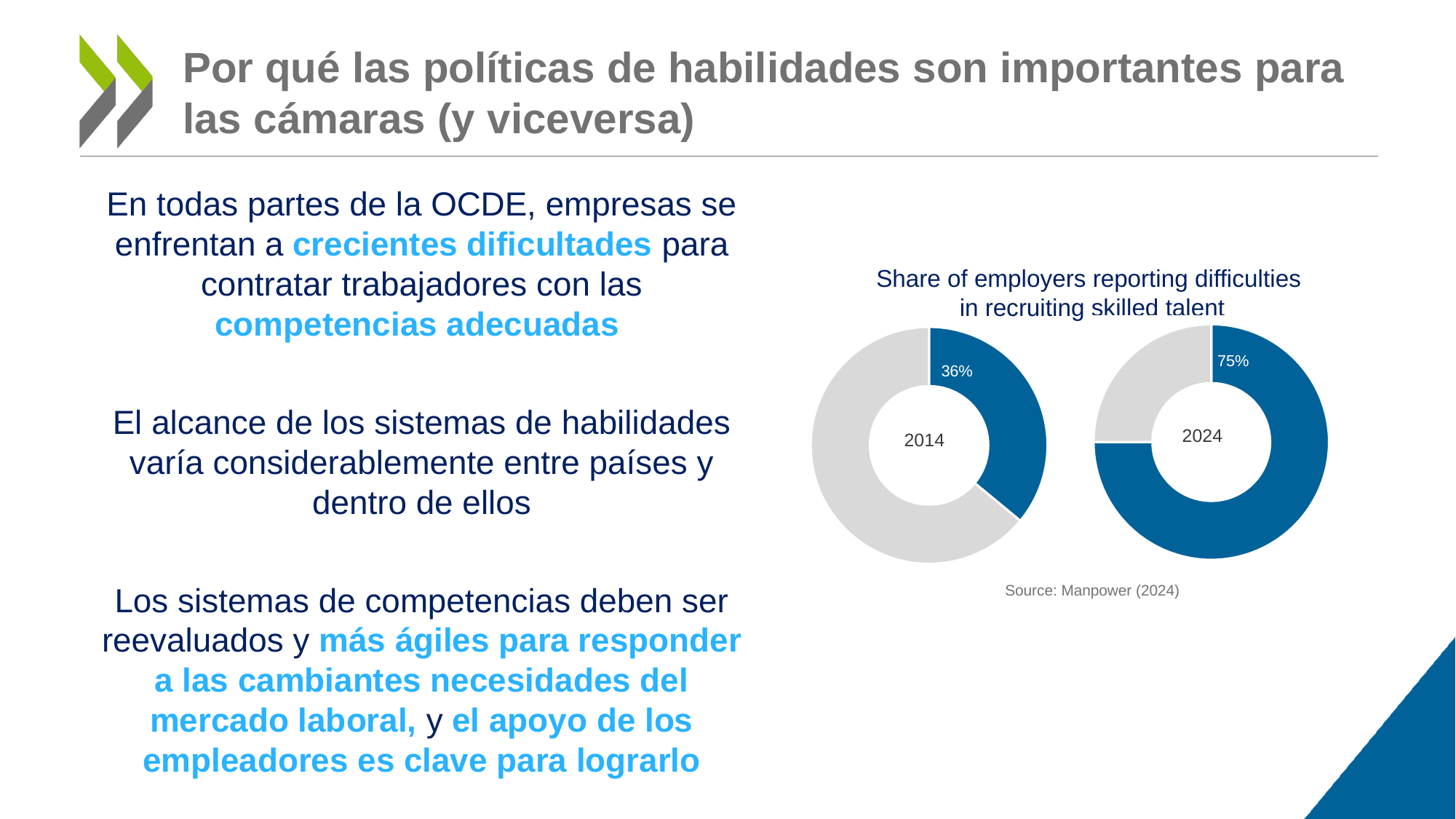
In the 2014 donut chart, is the highlighted share greater or less than 50%? less Comparing the 2014 and 2024 donut charts, which year shows the lower share of employers reporting difficulties? 2014 What type of chart is used to show the share of employers reporting difficulties in recruiting skilled talent? Donut (pie) chart In the 2014 donut chart, what share of employers reported difficulties in recruiting skilled talent? 36% Comparing the 2014 and 2024 donut charts, which year shows the higher share of employers reporting difficulties? 2024 In the 2024 donut chart, is the highlighted share greater or less than 50%? greater What source is cited below the donut charts? Manpower (2024) By how many percentage points did the share of employers reporting difficulties increase from the 2014 donut chart to the 2024 donut chart? 39 percentage points How many donut charts are shown on the slide? 2 Is the share shown in the 2014 donut chart larger or smaller than the share shown in the 2024 donut chart? smaller In the 2024 donut chart, what share of employers reported difficulties in recruiting skilled talent? 75% What is the title of the charts on the right side of the slide? Share of employers reporting difficulties in recruiting skilled talent